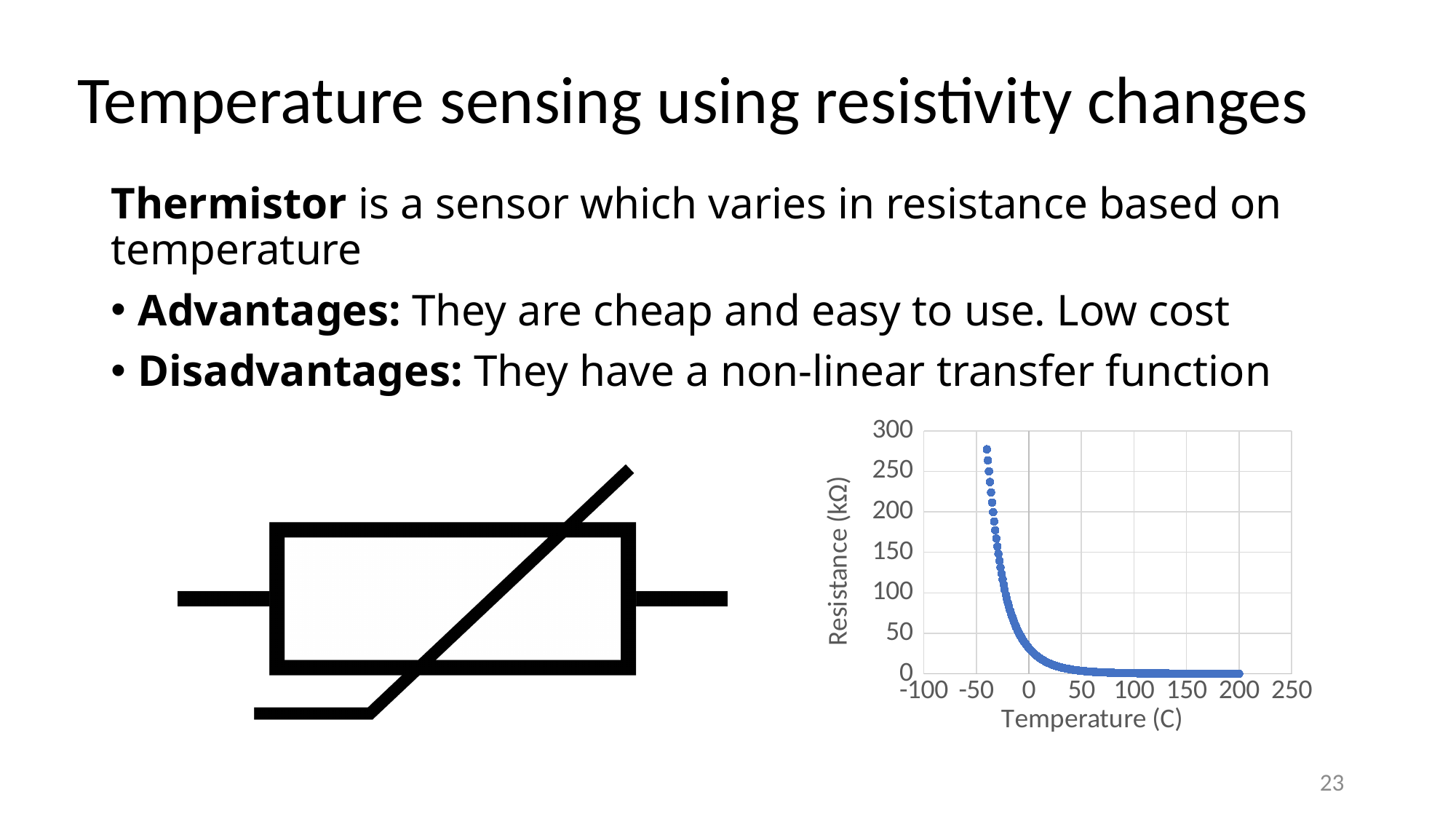
Does the resistance rise or fall as temperature increases along the x axis? fall Is the resistance at a temperature of 100 C greater or less than 50 kΩ? less At which end of the temperature range, low or high, is the resistance highest? low What is the label of the y axis of the chart? Resistance (kΩ) What is the highest value shown on the y axis of the chart? 300 What is the label of the x axis of the chart? Temperature (C) Is the resistance at a temperature of 0 C greater or less than 100 kΩ? less Is the highest plotted resistance value greater or less than 250 kΩ? greater What kind of chart is shown on the slide? scatter chart